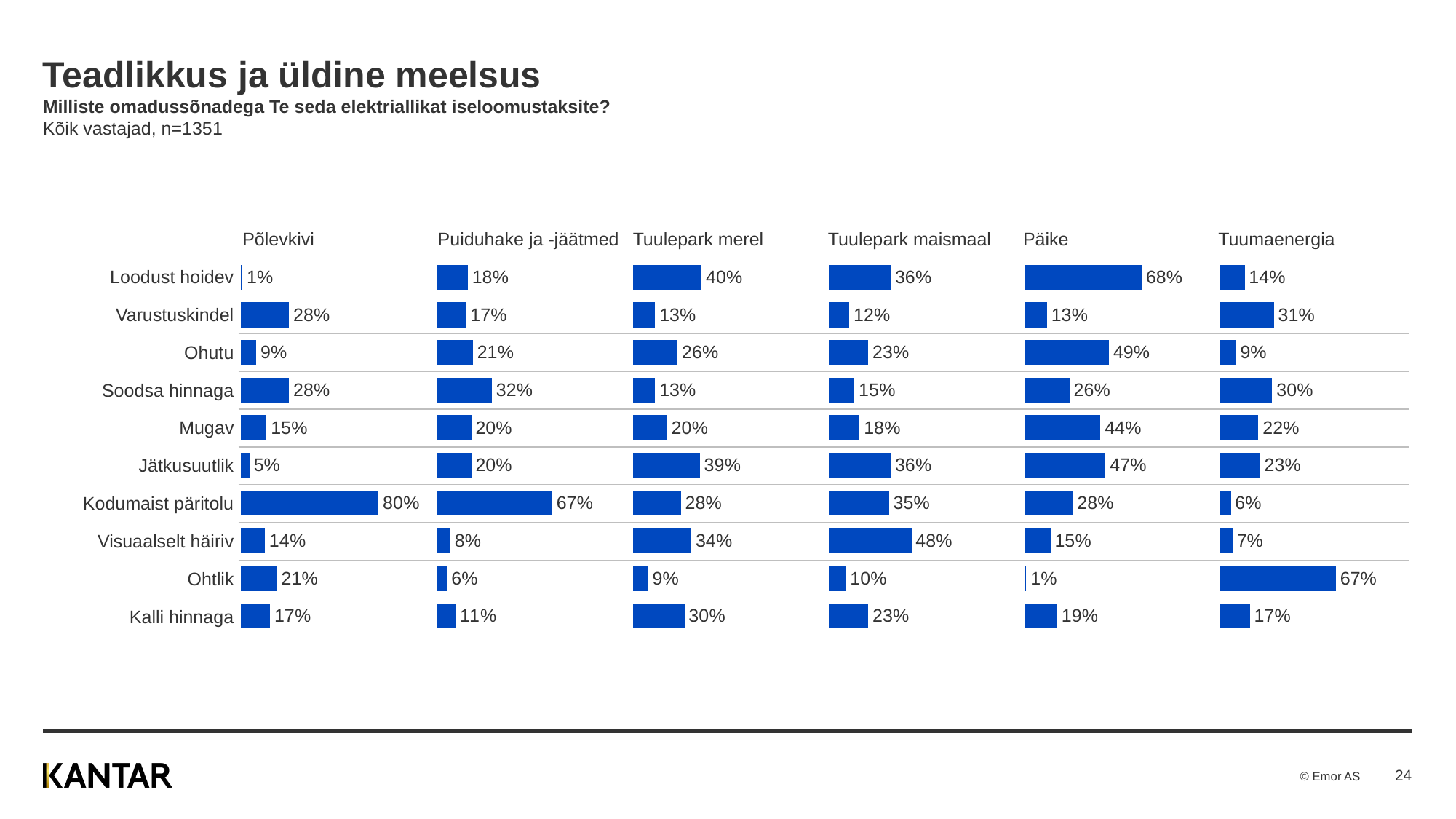
In the Päike chart, which category has the lowest value? Ohtlik In the Põlevkivi chart, what is the value for Kodumaist päritolu? 80% In the Tuulepark maismaal chart, which category has the highest value? Visuaalselt häiriv How many categories does each chart on the slide show? 10 In the Tuulepark merel chart, what is the difference between Loodust hoidev and Kalli hinnaga? 10% What kind of chart is used on the slide? Bar chart In the Tuumaenergia chart, which category has the highest value? Ohtlik In the Tuulepark maismaal chart, what is the value for Jätkusuutlik? 36% How many electricity sources (charts) are shown on the slide? 6 In the Päike chart, what is the value for Loodust hoidev? 68% In the Puiduhake ja -jäätmed chart, which is larger: Soodsa hinnaga or Ohutu? Soodsa hinnaga In the Põlevkivi chart, what is the difference between Varustuskindel and Ohutu? 19%